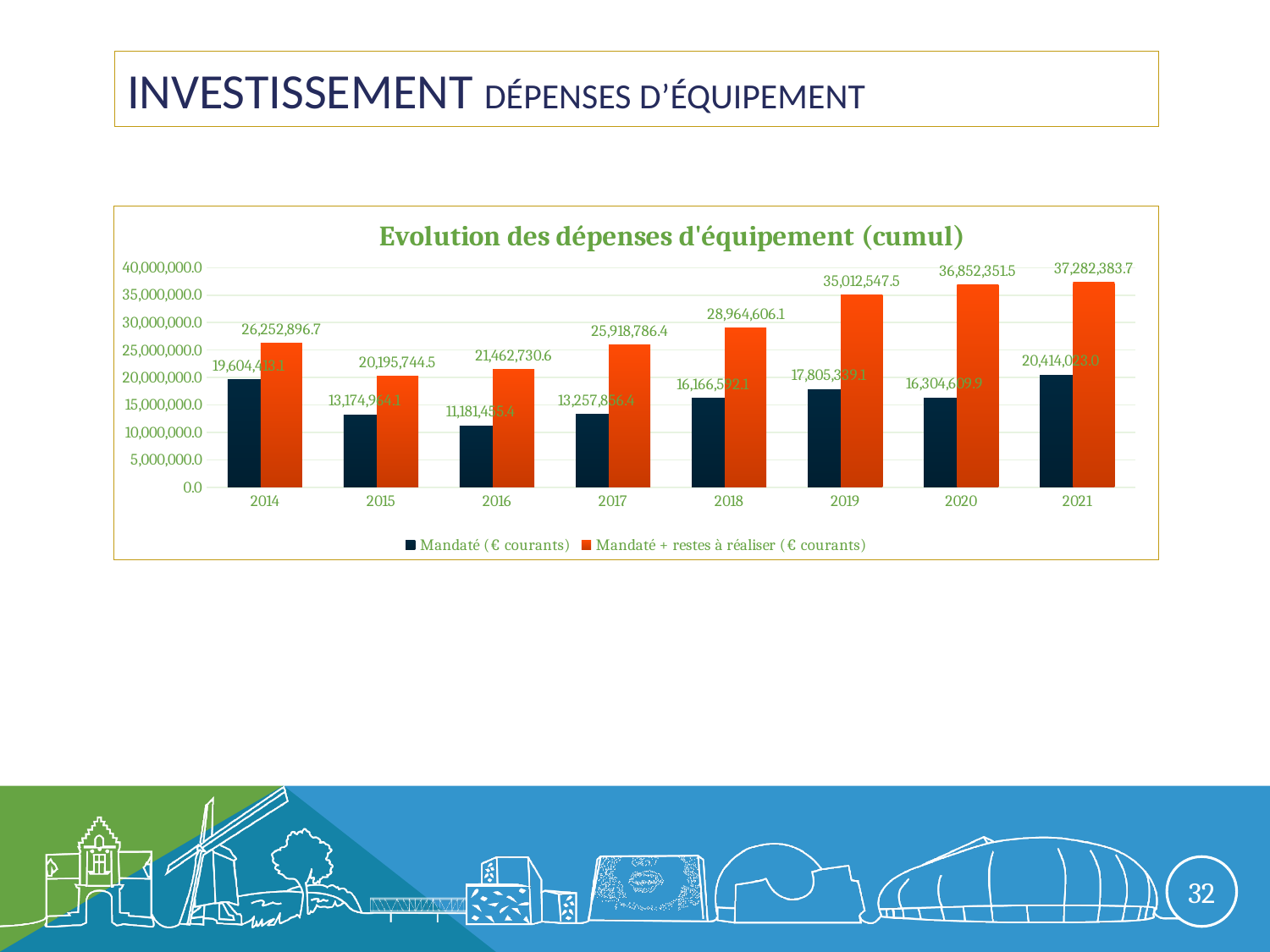
In which year is 'Mandaté (€ courants)' lowest? 2016 In which year is 'Mandaté + restes à réaliser (€ courants)' highest? 2021 How many series does the chart legend list? 2 How many years are shown on the x axis of the chart? 8 What type of chart is shown on the slide? bar chart Is the value of 'Mandaté (€ courants)' for 2019 greater or less than 15,000,000.0? greater In which year is 'Mandaté + restes à réaliser (€ courants)' lowest? 2015 What is the difference between 'Mandaté + restes à réaliser (€ courants)' in 2021 and in 2020? 430,032.2 Which year has the larger value for 'Mandaté + restes à réaliser (€ courants)', 2017 or 2018? 2018 Is the value of 'Mandaté (€ courants)' for 2016 greater or less than 15,000,000.0? less What is the value of 'Mandaté + restes à réaliser (€ courants)' for 2021? 37,282,383.7 What is the value of 'Mandaté + restes à réaliser (€ courants)' for 2014? 26,252,896.7